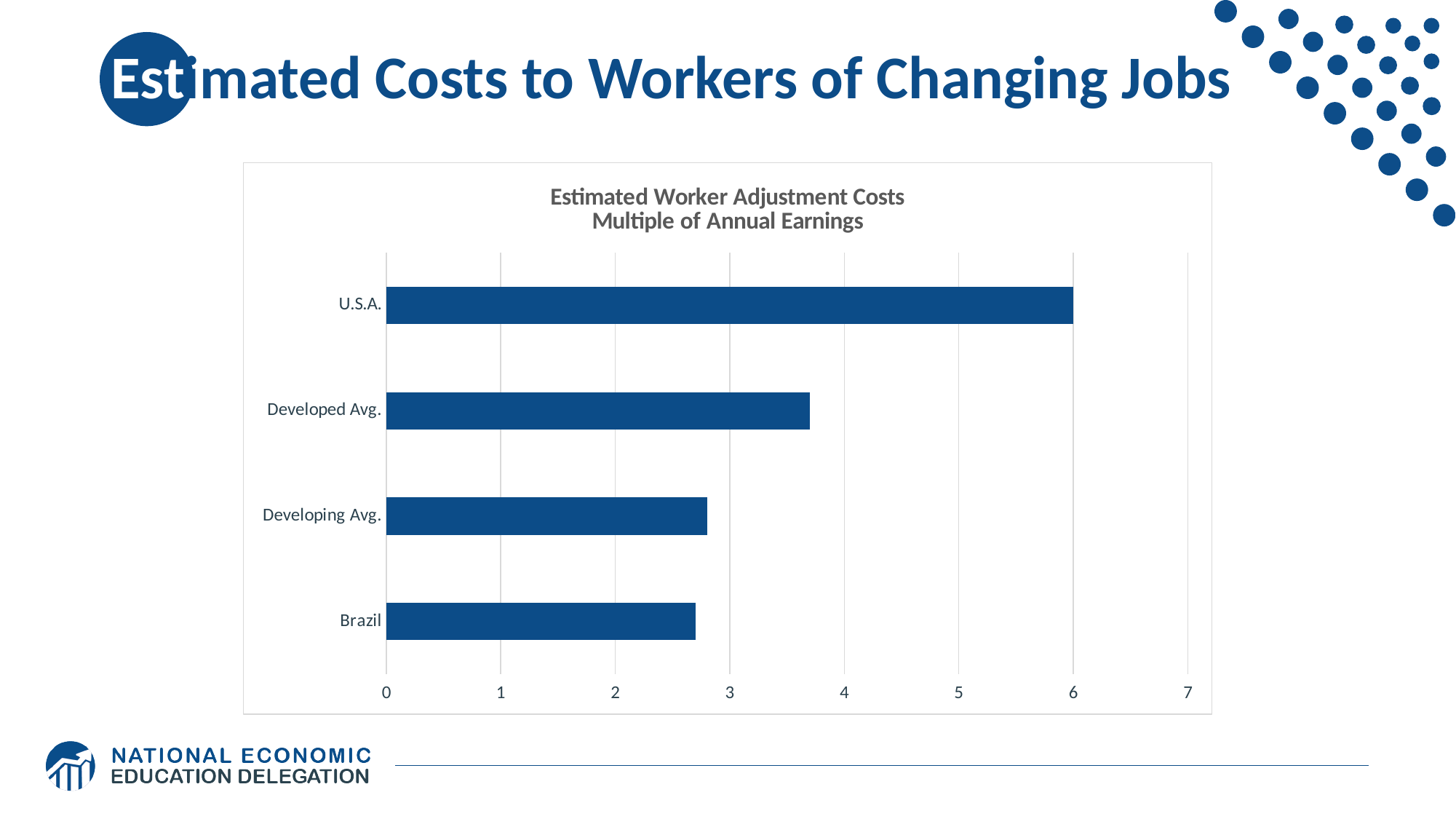
Which is larger, the value for U.S.A. or the value for Developed Avg.? U.S.A. Is the value for Brazil greater or less than 2? greater What is the maximum value shown on the horizontal axis? 7 Is the value for Developed Avg. greater or less than 3? greater Is the value for Developed Avg. greater or less than 4? less How many categories are plotted in the chart? 4 What is the value for U.S.A. in the chart? 6 What type of chart is shown on the slide? Bar chart What is the title of the chart? Estimated Worker Adjustment Costs Multiple of Annual Earnings Which category has the highest estimated worker adjustment cost? U.S.A. Which is larger, the value for Developed Avg. or the value for Brazil? Developed Avg.